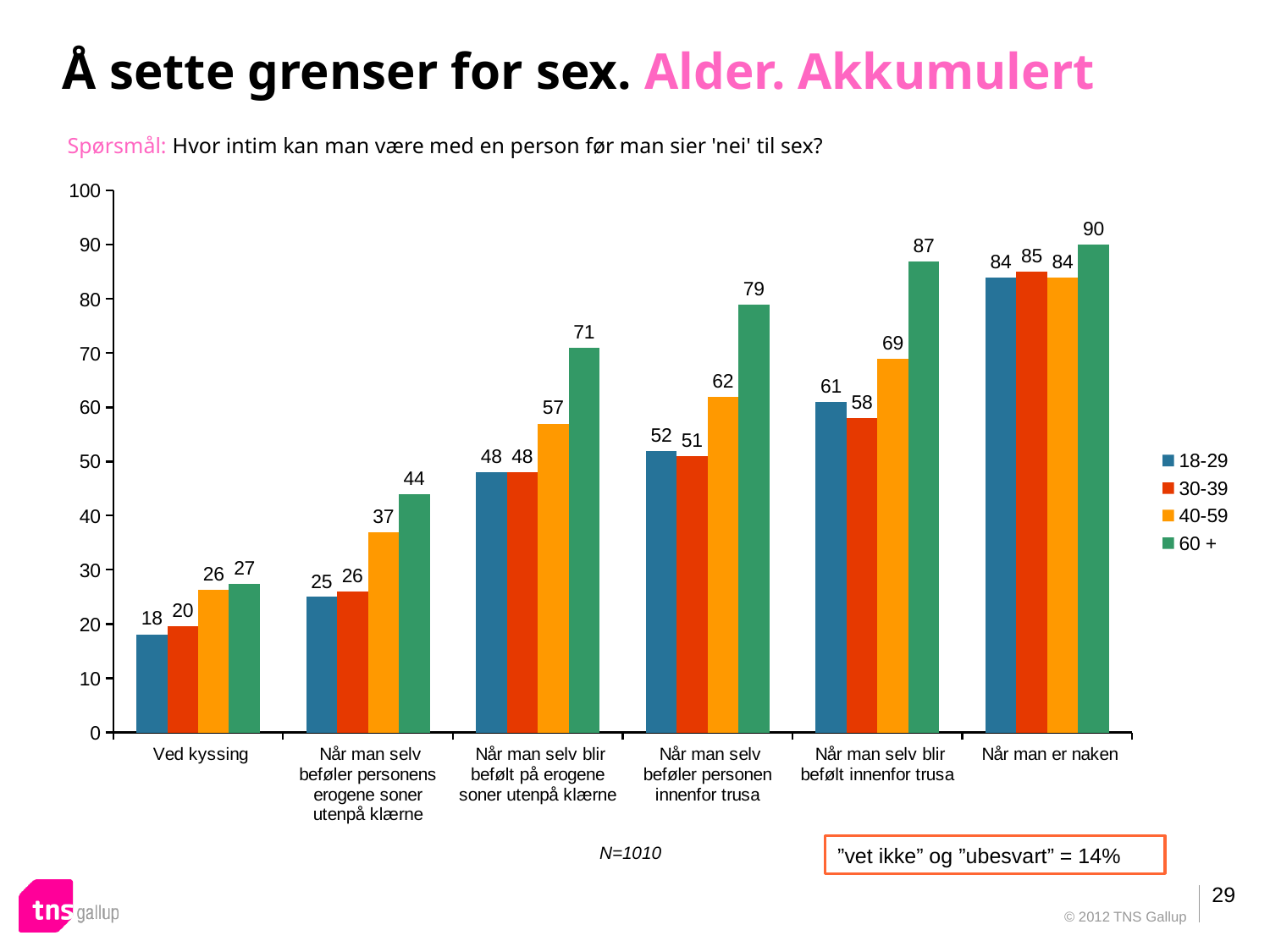
Which age group has the lowest value in the 'Ved kyssing' category? 18-29 Which is larger in the 'Når man selv blir befølt innenfor trusa' category: the 18-29 value or the 30-39 value? 18-29 What is the sample size (N) stated below the chart? N=1010 What is the value for the 60 + series in the 'Når man er naken' category? 90 What kind of chart is shown on the slide? Bar chart Which age group has the highest value in the 'Når man selv beføler personen innenfor trusa' category? 60 + What is the difference between the 60 + value and the 18-29 value in the 'Når man selv blir befølt på erogene soner utenpå klærne' category? 23 What is the value for the 40-59 series in the 'Når man selv blir befølt innenfor trusa' category? 69 What is the value for the 18-29 series in the 'Ved kyssing' category? 18 How many series does the legend list? 4 Do the values for the 60 + series rise or fall from left to right across the categories? Rise How many categories are shown on the x axis? 6